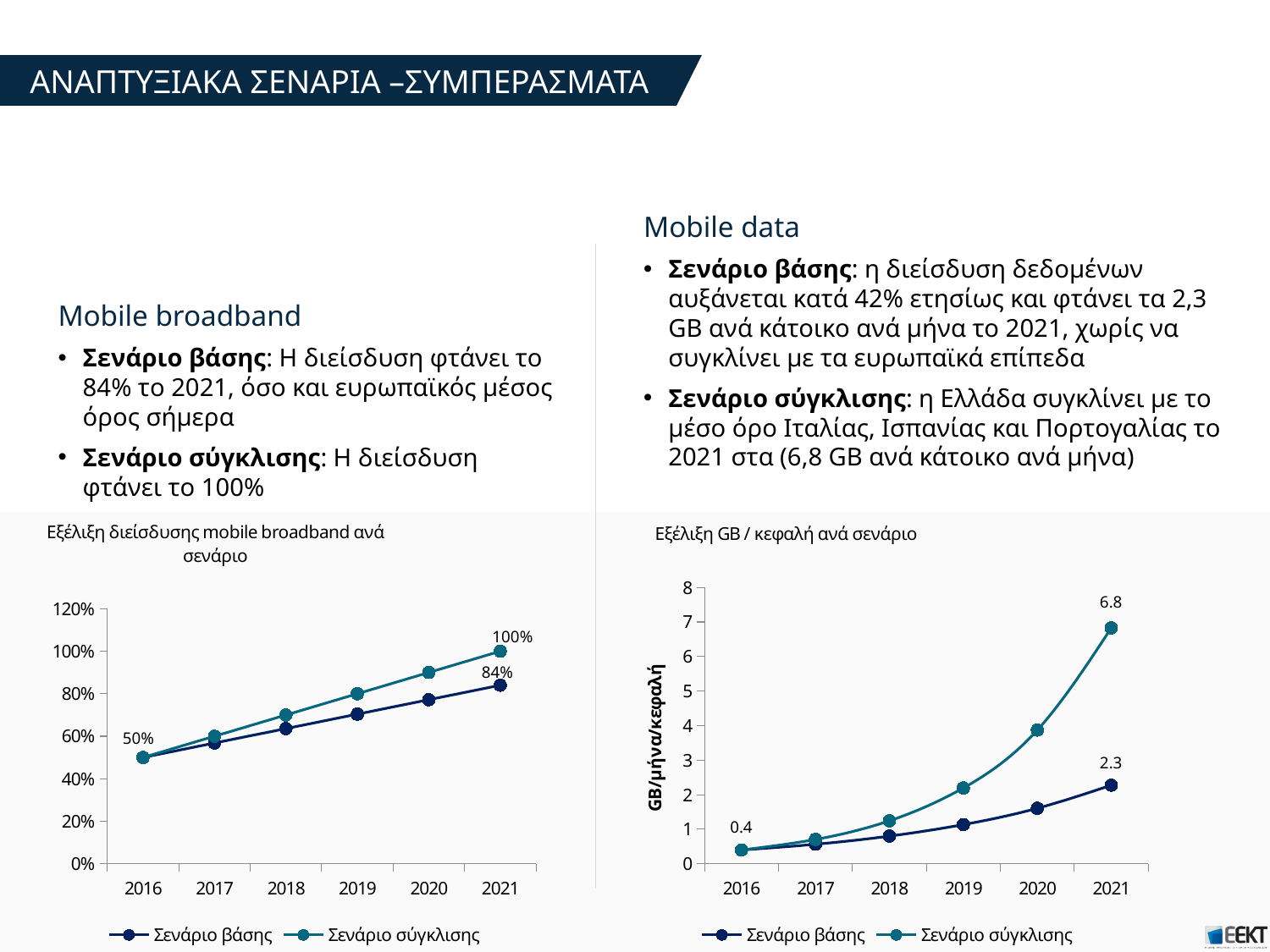
In the chart titled 'Εξέλιξη GB / κεφαλή ανά σενάριο', is the value of Σενάριο βάσης in 2019 greater or less than 2? less In the chart titled 'Εξέλιξη διείσδυσης mobile broadband ανά σενάριο', what is the difference between the two scenarios in 2021? 16% In the chart titled 'Εξέλιξη διείσδυσης mobile broadband ανά σενάριο', what is the value shown for 2016? 50% In the chart titled 'Εξέλιξη GB / κεφαλή ανά σενάριο', what is the label of the y axis? GB/μήνα/κεφαλή In the chart titled 'Εξέλιξη διείσδυσης mobile broadband ανά σενάριο', what is the value of Σενάριο σύγκλισης in 2021? 100% In the chart titled 'Εξέλιξη GB / κεφαλή ανά σενάριο', which scenario has the higher value in 2020? Σενάριο σύγκλισης In the chart titled 'Εξέλιξη διείσδυσης mobile broadband ανά σενάριο', how many years are shown on the x axis? 6 In the chart titled 'Εξέλιξη GB / κεφαλή ανά σενάριο', what is the value of Σενάριο σύγκλισης in 2021? 6.8 In the chart titled 'Εξέλιξη διείσδυσης mobile broadband ανά σενάριο', what is the value of Σενάριο βάσης in 2021? 84% In the chart titled 'Εξέλιξη GB / κεφαλή ανά σενάριο', what is the value of Σενάριο βάσης in 2021? 2.3 In the chart titled 'Εξέλιξη GB / κεφαλή ανά σενάριο', what is the difference between Σενάριο σύγκλισης and Σενάριο βάσης in 2021? 4.5 In the chart titled 'Εξέλιξη διείσδυσης mobile broadband ανά σενάριο', is the value of Σενάριο σύγκλισης in 2019 greater or less than 60%? greater